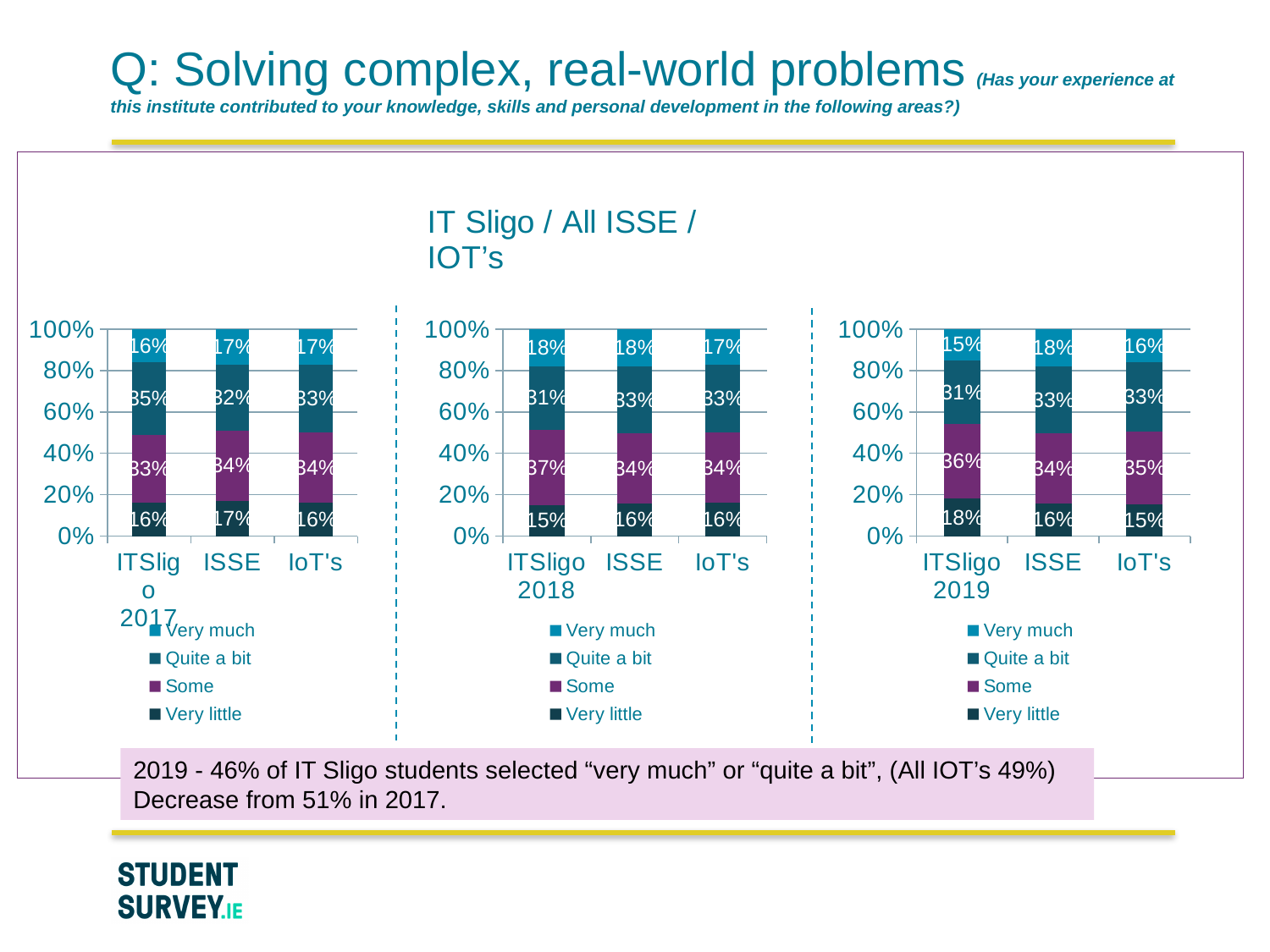
In the 2018 chart, what is the 'Very much' value for ITSligo? 18% What are the four legend entries in the 2017 chart? Very much, Quite a bit, Some, Very little How many series does the legend of the 2019 chart list? 4 In the 2019 chart, which category has the highest 'Very little' value? ITSligo How many categories are shown on the x axis of the 2018 chart? 3 In the 2018 chart, what is the 'Some' value for ITSligo? 37% In the 2019 chart, what is the difference between the 'Very much' values for ISSE and ITSligo? 3 percentage points In the 2019 chart, what is the 'Quite a bit' value for ISSE? 33% In the 2018 chart, which has the larger 'Some' value, ITSligo or ISSE? ITSligo In the 2019 chart, what is the 'Some' value for IoT's? 35% In the 2019 chart, what is the 'Very little' value for ITSligo? 18% What kind of chart is used on this slide for the 2018 data? Stacked bar chart